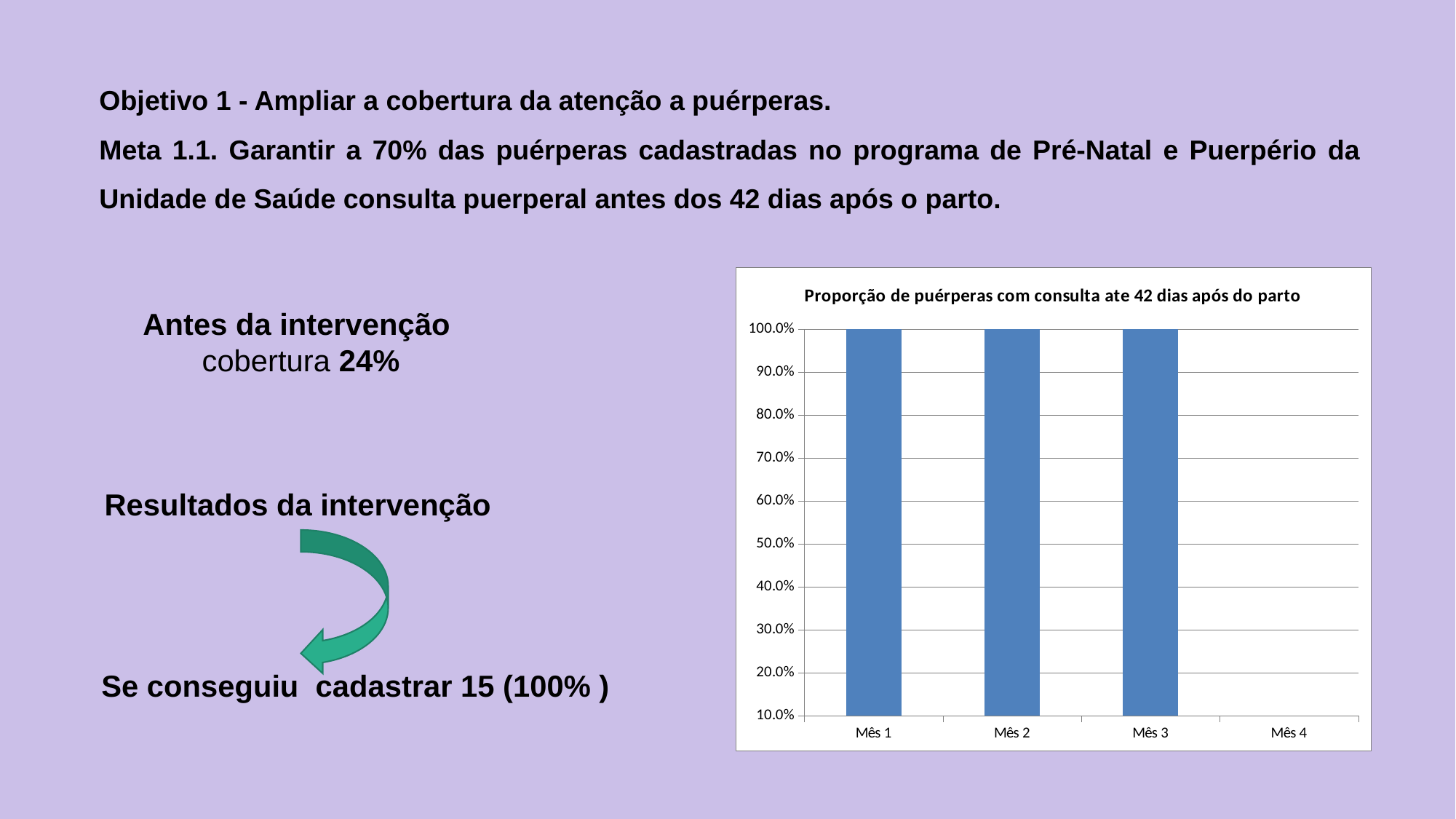
Which is larger, the value for Mês 1 or the value for Mês 4? Mês 1 What colour are the bars in the chart? blue Is the value for Mês 2 greater or less than 70.0%? greater What is the value for Mês 2 in the chart? 100.0% Which month category has no bar plotted in the chart? Mês 4 What is the difference between the values for Mês 1 and Mês 3? 0.0% What is the value for Mês 1 in the chart? 100.0% How many month categories are shown on the x axis of the chart? 4 What kind of chart is shown on the slide? bar chart What is the value for Mês 3 in the chart? 100.0% What is the title of the chart? Proporção de puérperas com consulta ate 42 dias após do parto Do the values rise, fall or stay the same from Mês 1 to Mês 3? stay the same